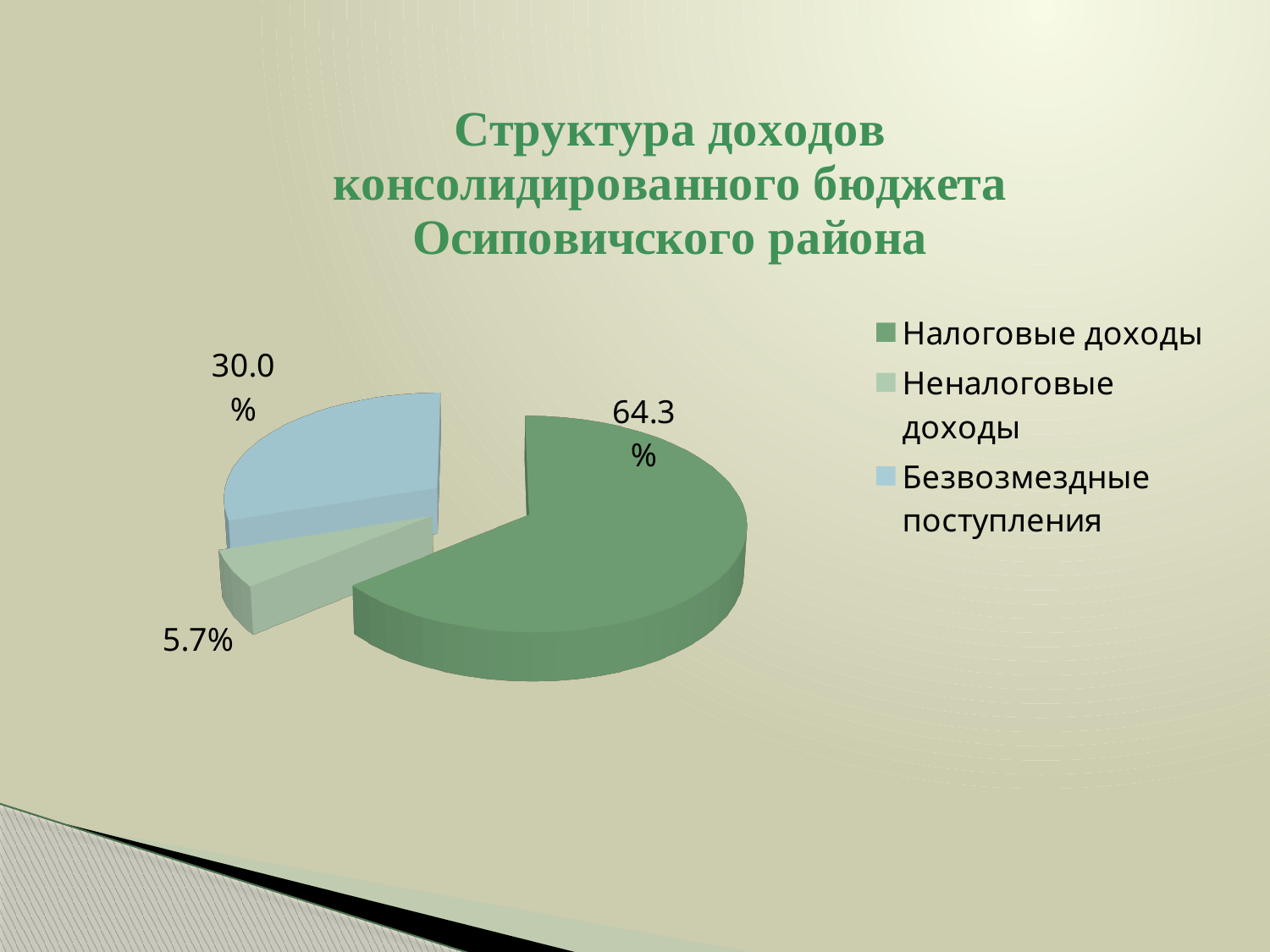
What share of the pie does Неналоговые доходы have? 5.7% What kind of chart is shown on the slide? Pie chart What is the difference in percentage points between Налоговые доходы and Безвозмездные поступления? 34.3 Which is larger, the share for Безвозмездные поступления or the share for Неналоговые доходы? Безвозмездные поступления What share of the pie does Безвозмездные поступления have? 30.0% What share of the pie does Налоговые доходы have? 64.3% Which category has the largest slice of the pie? Налоговые доходы What is the difference in percentage points between Безвозмездные поступления and Неналоговые доходы? 24.3 How many slices does the pie chart have? 3 What is the title of the chart? Структура доходов консолидированного бюджета Осиповичского района Which colour represents Безвозмездные поступления in the legend? Light blue Which category has the smallest slice of the pie? Неналоговые доходы